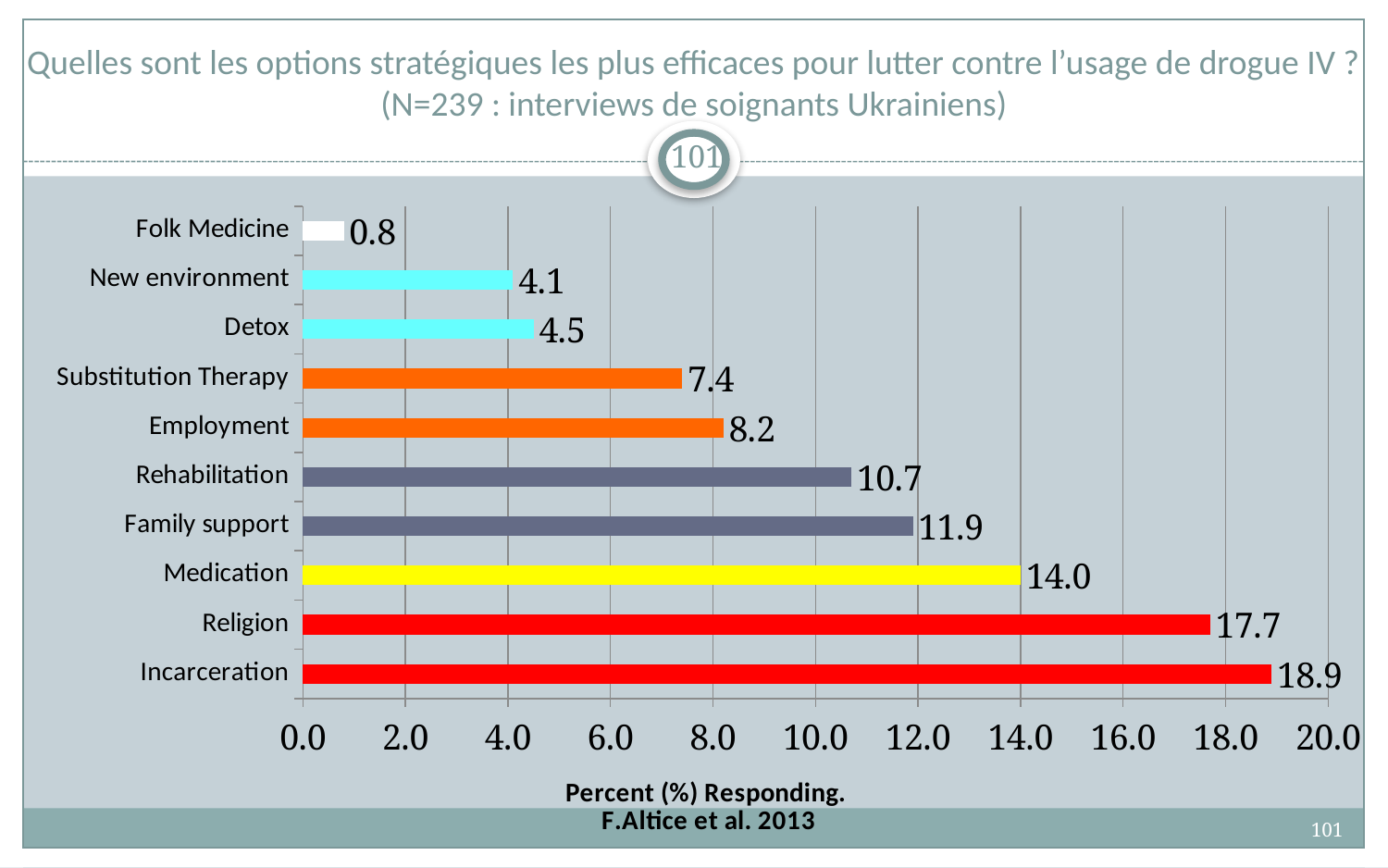
What is the difference between the values for Religion and Medication? 3.7 Is the value for Employment greater or less than 10.0? less How many categories are shown in the chart? 10 What kind of chart is shown on the slide? bar chart Which category has the lowest value? Folk Medicine What is the value for Folk Medicine? 0.8 What colour is the bar for Medication? yellow What is the label of the horizontal axis? Percent (%) Responding. Which is larger, the value for Rehabilitation or the value for Family support? Family support What is the value for Incarceration? 18.9 What is the value for Substitution Therapy? 7.4 Which category has the highest value? Incarceration